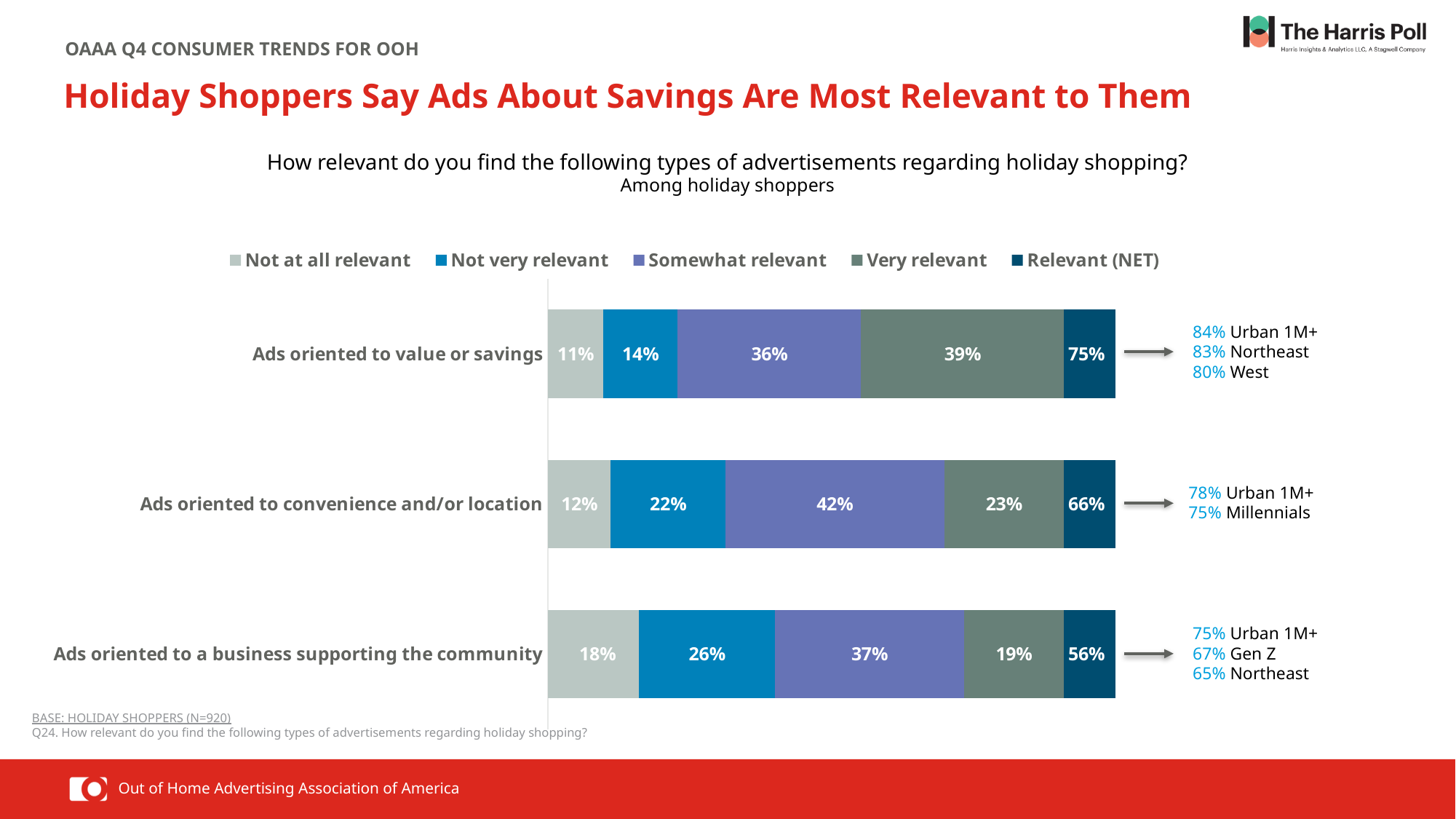
Which type of advertisement has the lowest 'Very relevant' percentage? Ads oriented to a business supporting the community What is the base size noted for the chart? N=920 What is the 'Not very relevant' percentage for ads oriented to convenience and/or location? 22% What kind of chart is shown on the slide? Stacked bar chart How many types of advertisements are shown in the chart? 3 Which is larger: the 'Somewhat relevant' share for ads oriented to convenience and/or location or for ads oriented to value or savings? Ads oriented to convenience and/or location What is the difference between the 'Relevant (NET)' values for ads oriented to value or savings and ads oriented to a business supporting the community? 19 percentage points Which type of advertisement has the highest 'Relevant (NET)' value? Ads oriented to value or savings What percentage of holiday shoppers find ads oriented to a business supporting the community 'Not at all relevant'? 18% How many series does the legend list? 5 What percentage of holiday shoppers find ads oriented to value or savings 'Very relevant'? 39% What is the 'Relevant (NET)' value for ads oriented to convenience and/or location? 66%